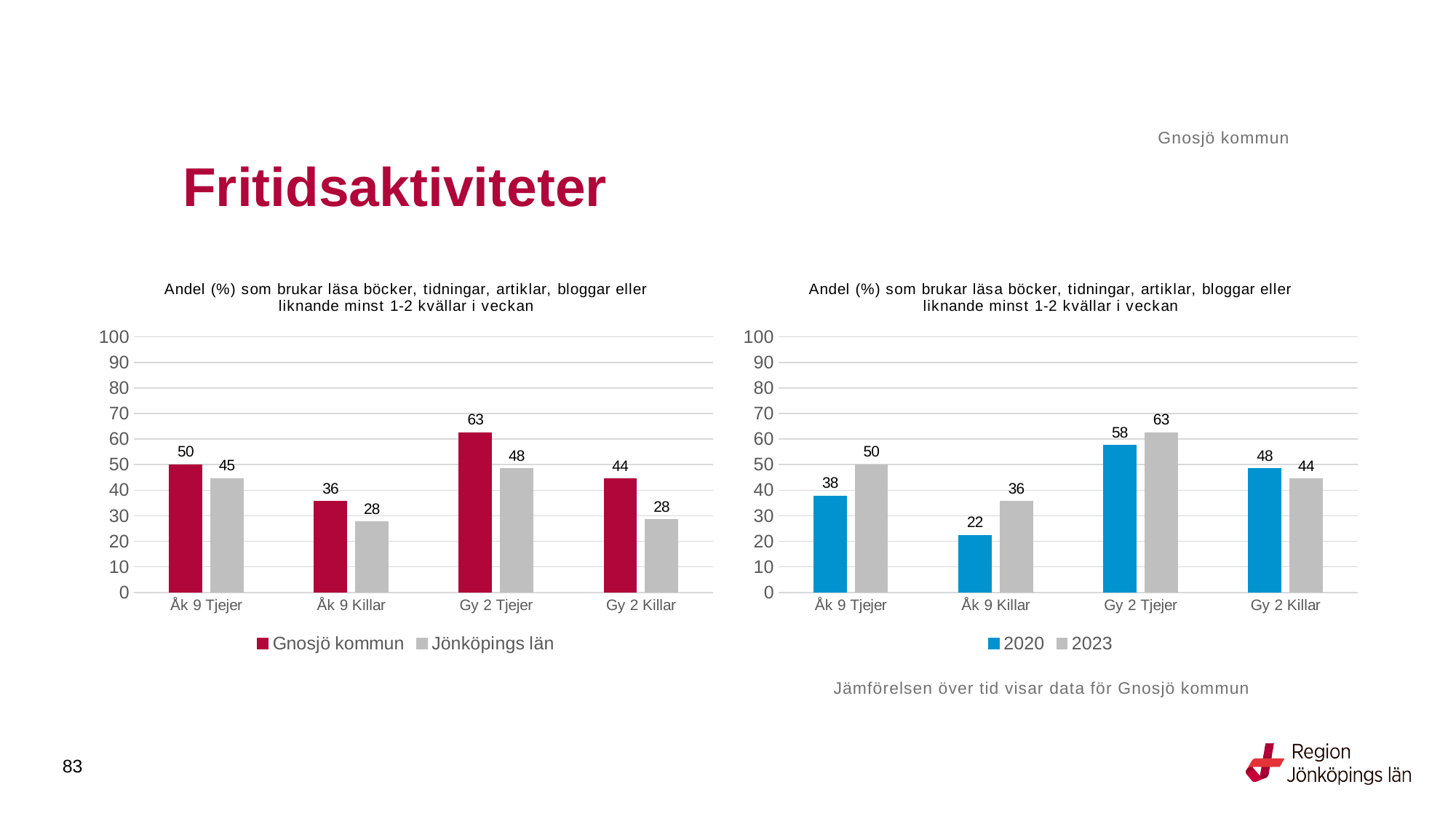
In the right chart, which category has the lowest 2020 value? Åk 9 Killar In the right chart, what is the 2020 value for Åk 9 Killar? 22 In the left chart, what is the difference between Gnosjö kommun and Jönköpings län for Gy 2 Killar? 16 How many categories are shown on the x axis of the left chart? 4 What type of chart is the left chart? Bar chart How many series does the legend of the right chart list? 2 In the left chart, which category has the highest value for Gnosjö kommun? Gy 2 Tjejer In the right chart, what is the 2023 value for Gy 2 Tjejer? 63 In the right chart, which is larger for Gy 2 Killar: the 2020 value or the 2023 value? 2020 In the left chart, what is the value for Gnosjö kommun for Gy 2 Tjejer? 63 In the right chart, what is the difference between the 2023 and 2020 values for Åk 9 Killar? 14 In the left chart, what is the value for Jönköpings län for Åk 9 Killar? 28